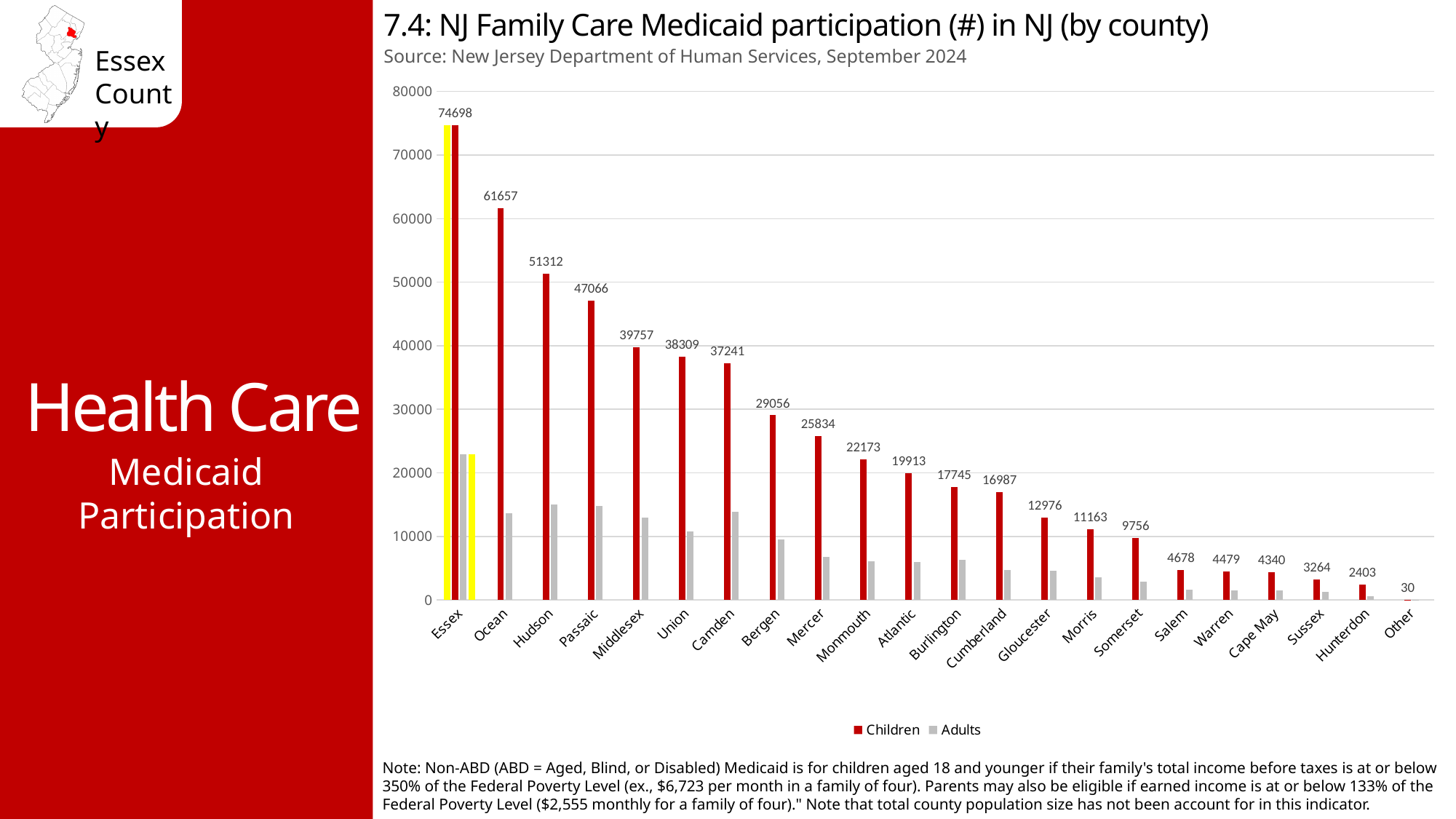
Is the Adults value for Essex greater or less than 20000? greater Which has a larger Children value, Middlesex or Camden? Middlesex How many counties/categories are shown along the x axis? 22 Which category has the lowest Children value? Other What is the Children value for Hunterdon? 2403 What type of chart is shown on the slide? bar chart How many series does the legend list? 2 What is the difference between the Children values for Essex and Ocean? 13041 Do the Children values rise or fall moving from left to right along the x axis? fall Which county has the highest Children value? Essex What is the Children value for Bergen? 29056 What is the Children value for Essex? 74698